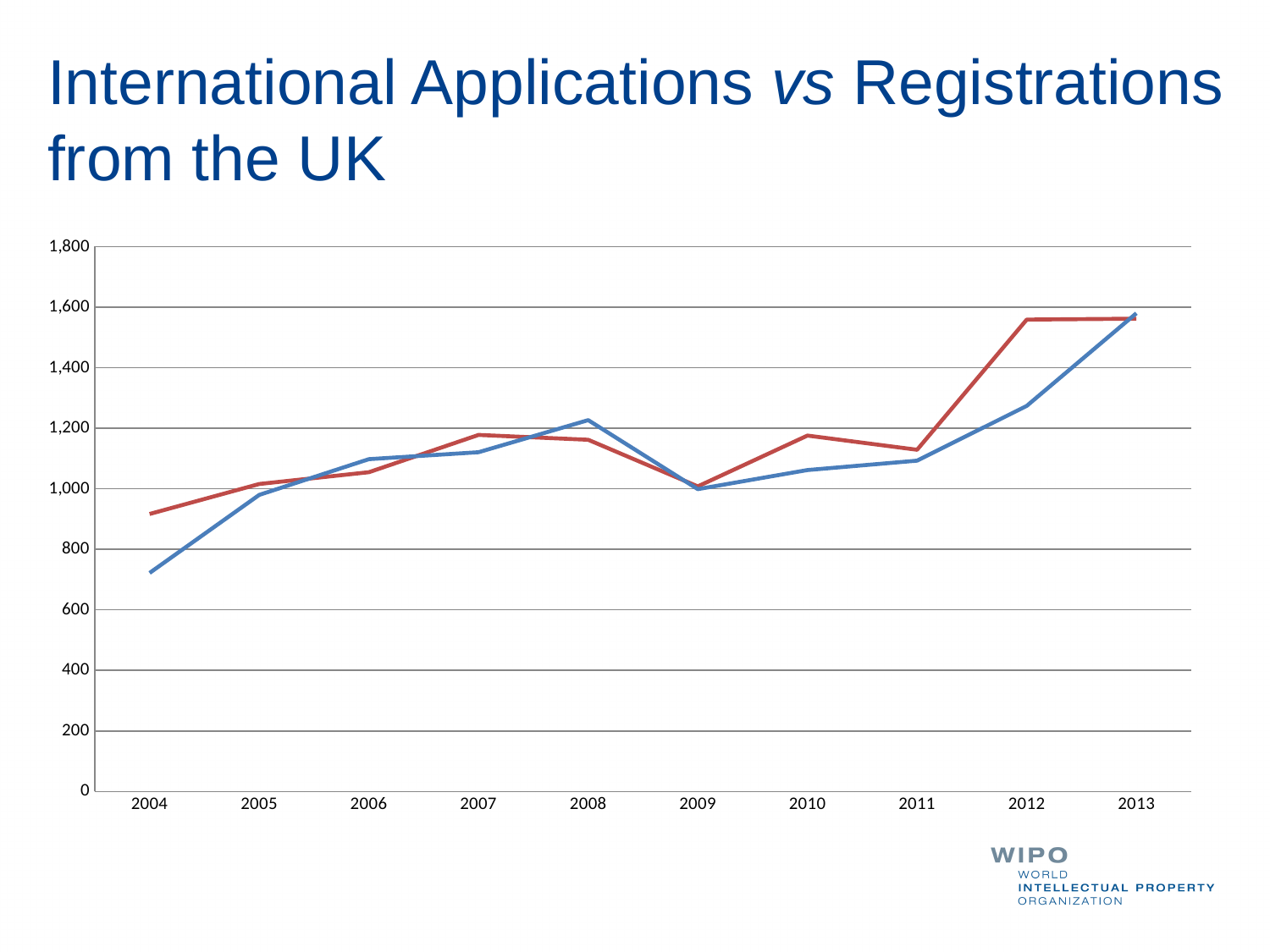
In which year is the blue line at its lowest value? 2004 How many years are shown along the x axis of the chart? 10 In 2012, which line has the higher value, the blue line or the red line? the red line In which year is the red line at its lowest value? 2004 What kind of chart is shown on the slide? line chart Is the value of the red line in 2004 greater or less than 800? greater Is the value of the blue line in 2012 greater or less than 1,400? less How many lines are plotted on the chart? 2 What is the title of the slide containing the chart? International Applications vs Registrations from the UK Is the value of the blue line in 2004 greater or less than 800? less Does the blue line rise or fall between 2011 and 2013? rise In which year is the blue line at its highest value? 2013